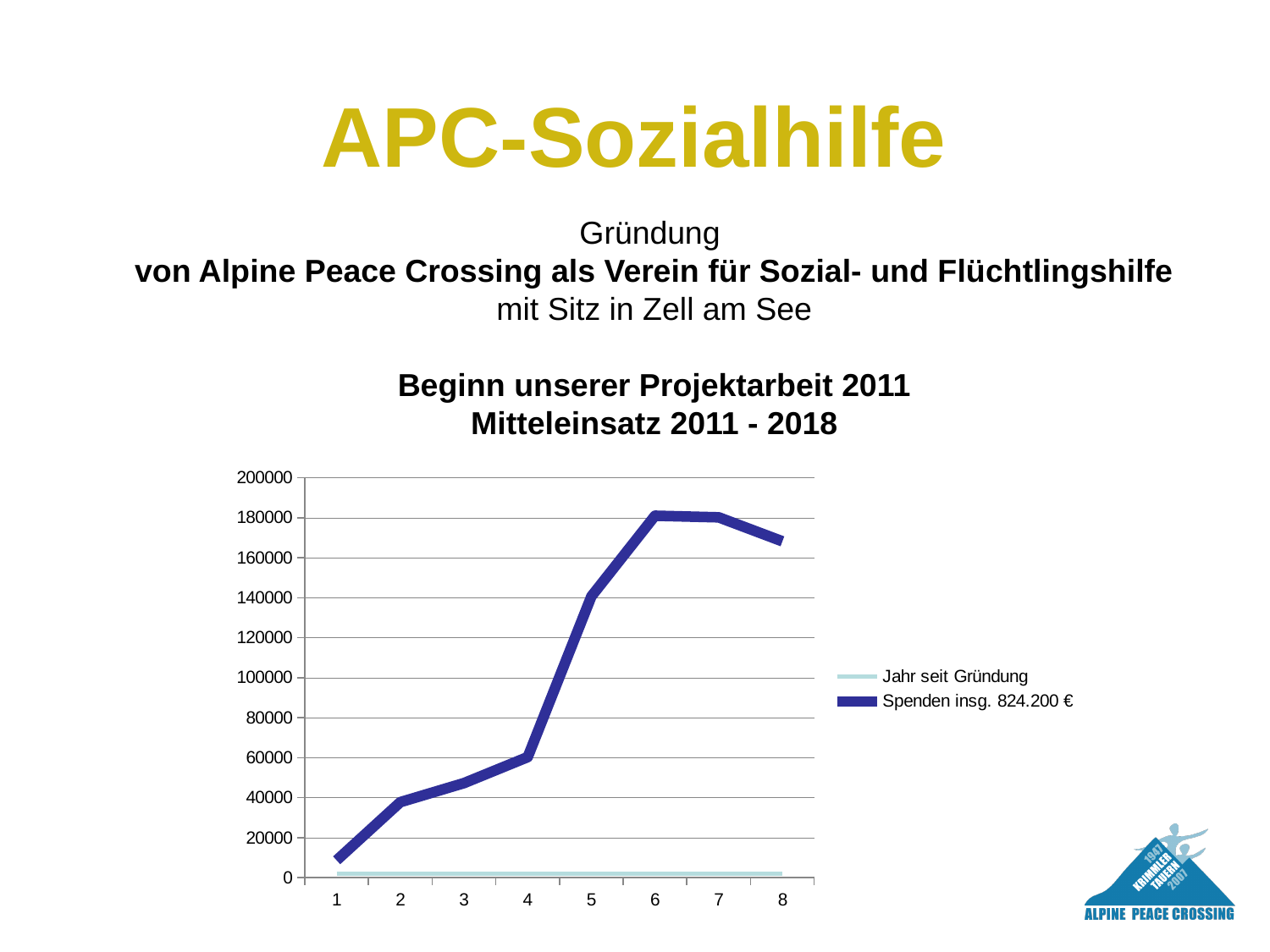
What is the second legend entry of the chart? Spenden insg. 824.200 € Is the Spenden value at point 1 greater or less than 20000? less Which has the larger Spenden value, point 4 or point 5? point 5 Is the Spenden value at point 6 greater or less than 160000? greater Is the Spenden value at point 5 greater or less than 120000? greater What kind of chart is shown on the slide? line chart Which x-axis point has the lowest value for the Spenden series? 1 How many series does the chart legend list? 2 Does the Spenden series rise or fall from point 1 to point 6? rise Which has the larger Spenden value, point 6 or point 8? point 6 How many points are plotted along the x axis of the chart? 8